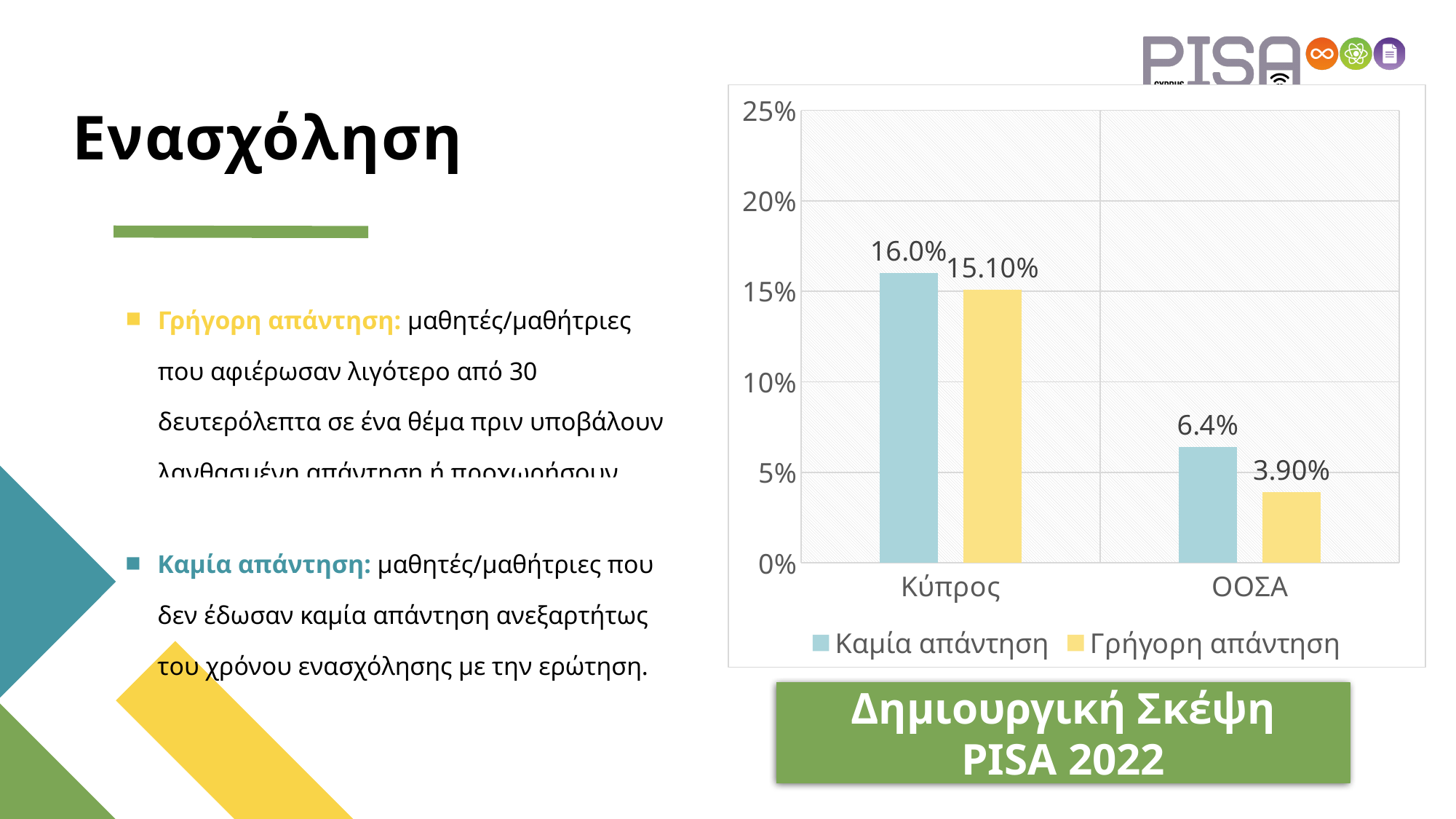
Which category has the lowest value for Γρήγορη απάντηση? ΟΟΣΑ How many series does the chart legend list? 2 What is the value for Γρήγορη απάντηση for Κύπρος? 15.10% Which category has the highest value for Καμία απάντηση? Κύπρος What is the value for Γρήγορη απάντηση for ΟΟΣΑ? 3.90% Which is larger for ΟΟΣΑ: Καμία απάντηση or Γρήγορη απάντηση? Καμία απάντηση How many categories are shown on the x axis of the chart? 2 What is the value for Καμία απάντηση for Κύπρος? 16.0% What kind of chart is shown on the slide? Bar chart What is the difference between the Καμία απάντηση and Γρήγορη απάντηση values for ΟΟΣΑ? 2.5 percentage points What is the difference between the Καμία απάντηση values for Κύπρος and ΟΟΣΑ? 9.6 percentage points What is the value for Καμία απάντηση for ΟΟΣΑ? 6.4%